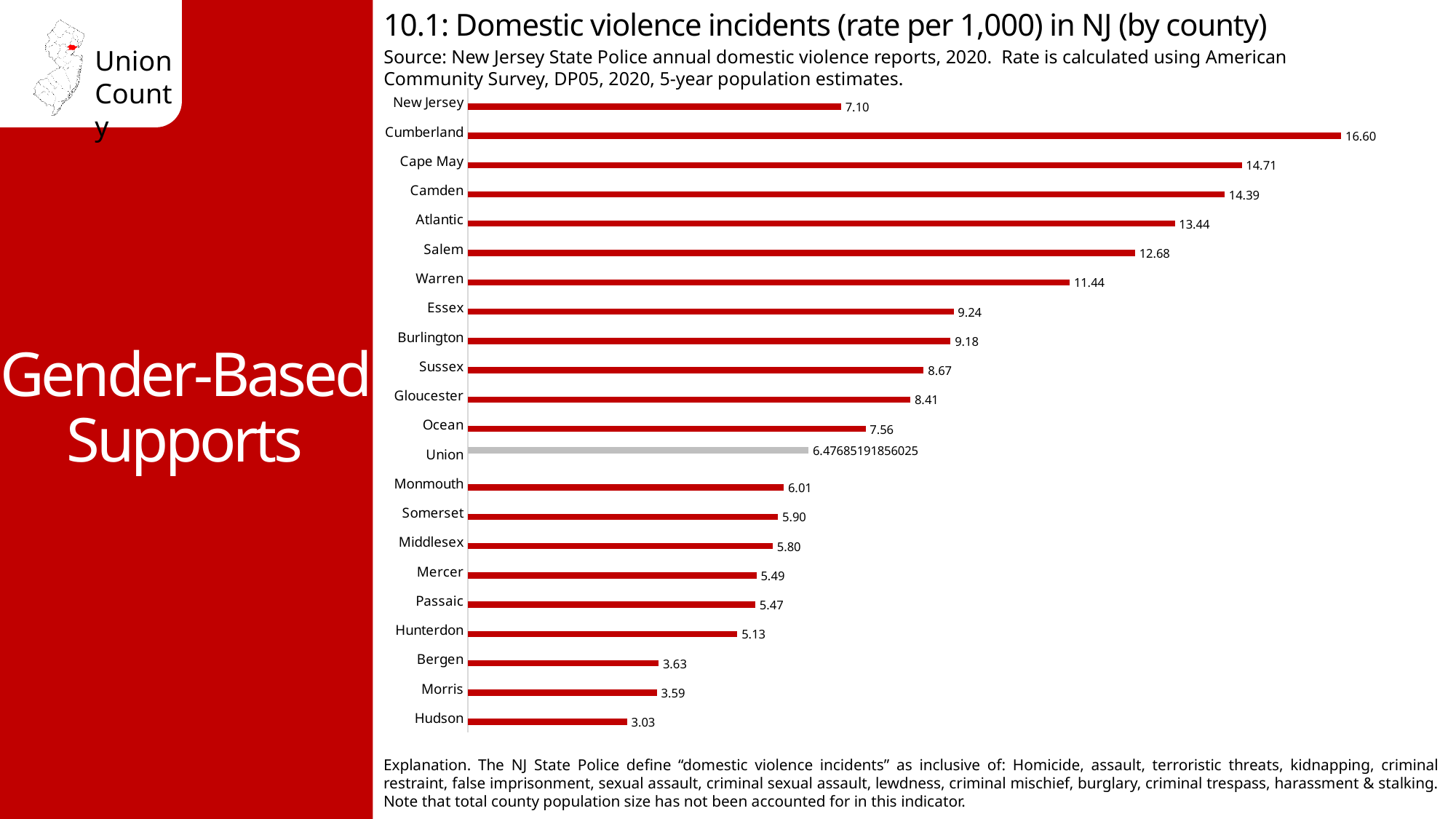
Which county has the highest domestic violence incident rate? Cumberland What type of chart is shown on the slide? Bar chart Which has a higher domestic violence incident rate, Warren or Salem? Salem Which bar is shown in a different colour (grey) from the others? Union How many bars (counties plus the state total) are shown in the chart? 22 What is the difference between the rates for Cumberland and Hudson? 13.57 What is the domestic violence incident rate per 1,000 for Hudson? 3.03 What is the domestic violence incident rate per 1,000 for New Jersey overall? 7.10 What is the difference between the rates for Cape May and Camden? 0.32 What is the domestic violence incident rate per 1,000 for Cumberland? 16.60 Which has a higher domestic violence incident rate, Essex or Ocean? Essex Which county has the lowest domestic violence incident rate? Hudson